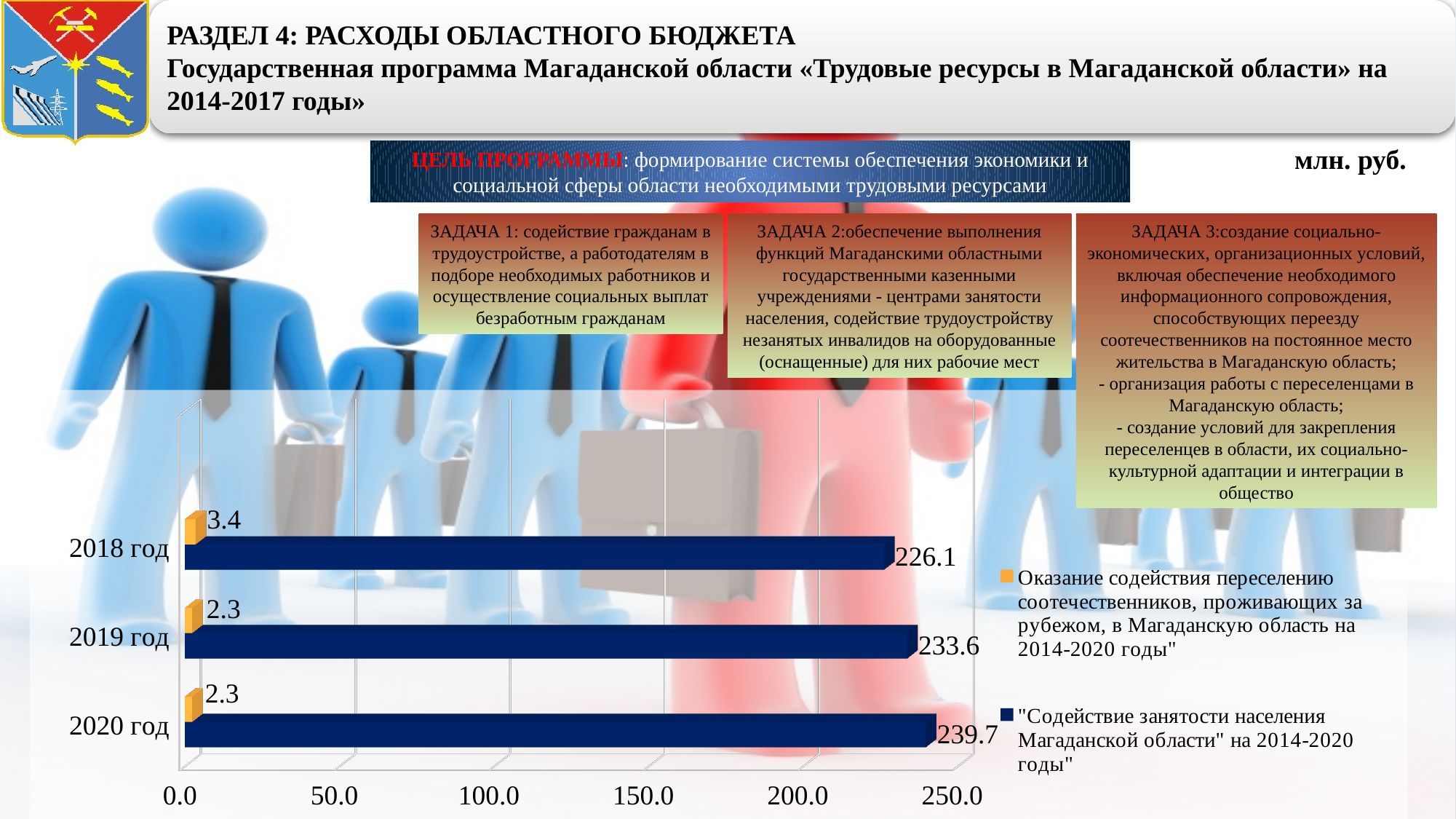
How many series does the chart legend list? 2 What is the difference between the 2020 год and 2018 год values in the "Содействие занятости населения Магаданской области" series? 13.6 Do the values in the "Содействие занятости населения Магаданской области" series rise or fall from 2018 год to 2020 год? Rise Which year has the highest value in the "Содействие занятости населения Магаданской области" series? 2020 год Which year has the lowest value in the "Содействие занятости населения Магаданской области" series? 2018 год What is the value for 2018 год in the "Оказание содействия переселению соотечественников" series? 3.4 What type of chart is shown on the slide? Bar chart Which is larger: the 2019 год value or the 2018 год value in the "Содействие занятости населения Магаданской области" series? 2019 год What is the value for 2018 год in the "Содействие занятости населения Магаданской области" series? 226.1 What is the value for 2020 год in the "Содействие занятости населения Магаданской области" series? 239.7 What is the value for 2019 год in the "Оказание содействия переселению соотечественников" series? 2.3 How many years (categories) are shown on the chart? 3